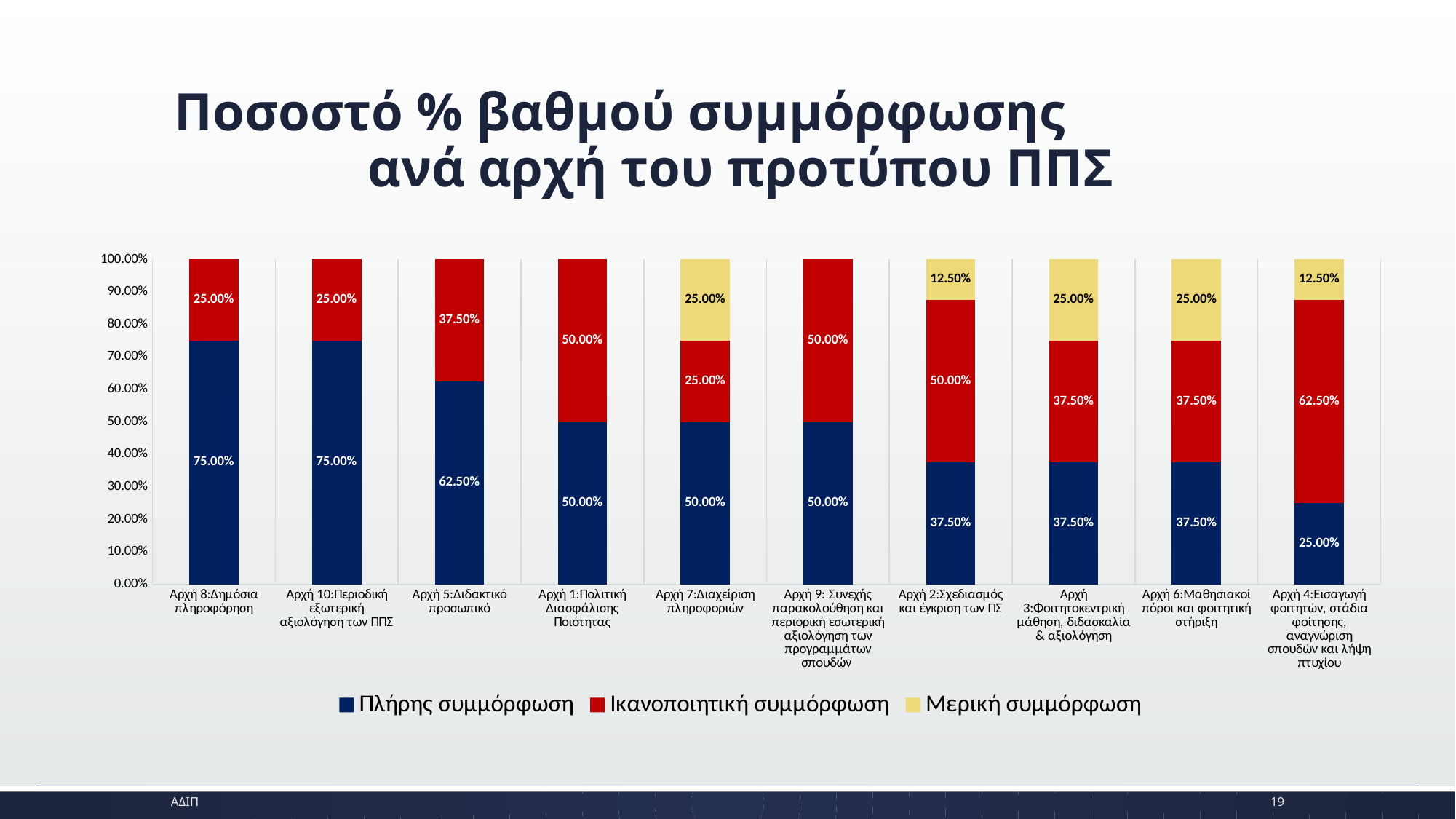
Which is larger: the Πλήρης συμμόρφωση value for Αρχή 5:Διδακτικό προσωπικό or for Αρχή 6:Μαθησιακοί πόροι και φοιτητική στήριξη? Αρχή 5:Διδακτικό προσωπικό What is the value of Μερική συμμόρφωση for Αρχή 2:Σχεδιασμός και έγκριση των ΠΣ? 12.50% How many categories are shown on the x axis? 10 What is the value of Πλήρης συμμόρφωση for Αρχή 5:Διδακτικό προσωπικό? 62.50% Do the Πλήρης συμμόρφωση values rise or fall from left to right along the x axis? Fall Which category has the highest value for Ικανοποιητική συμμόρφωση? Αρχή 4:Εισαγωγή φοιτητών, στάδια φοίτησης, αναγνώριση σπουδών και λήψη πτυχίου What is the value of Ικανοποιητική συμμόρφωση for Αρχή 4:Εισαγωγή φοιτητών, στάδια φοίτησης, αναγνώριση σπουδών και λήψη πτυχίου? 62.50% What kind of chart is shown on the slide? Stacked bar chart How many series does the legend list? 3 What is the difference between the Πλήρης συμμόρφωση values for Αρχή 8:Δημόσια πληροφόρηση and Αρχή 1:Πολιτική Διασφάλισης Ποιότητας? 25.00% What is the total of the stacked bar for Αρχή 7:Διαχείριση πληροφοριών? 100.00% Which category has the lowest value for Πλήρης συμμόρφωση? Αρχή 4:Εισαγωγή φοιτητών, στάδια φοίτησης, αναγνώριση σπουδών και λήψη πτυχίου